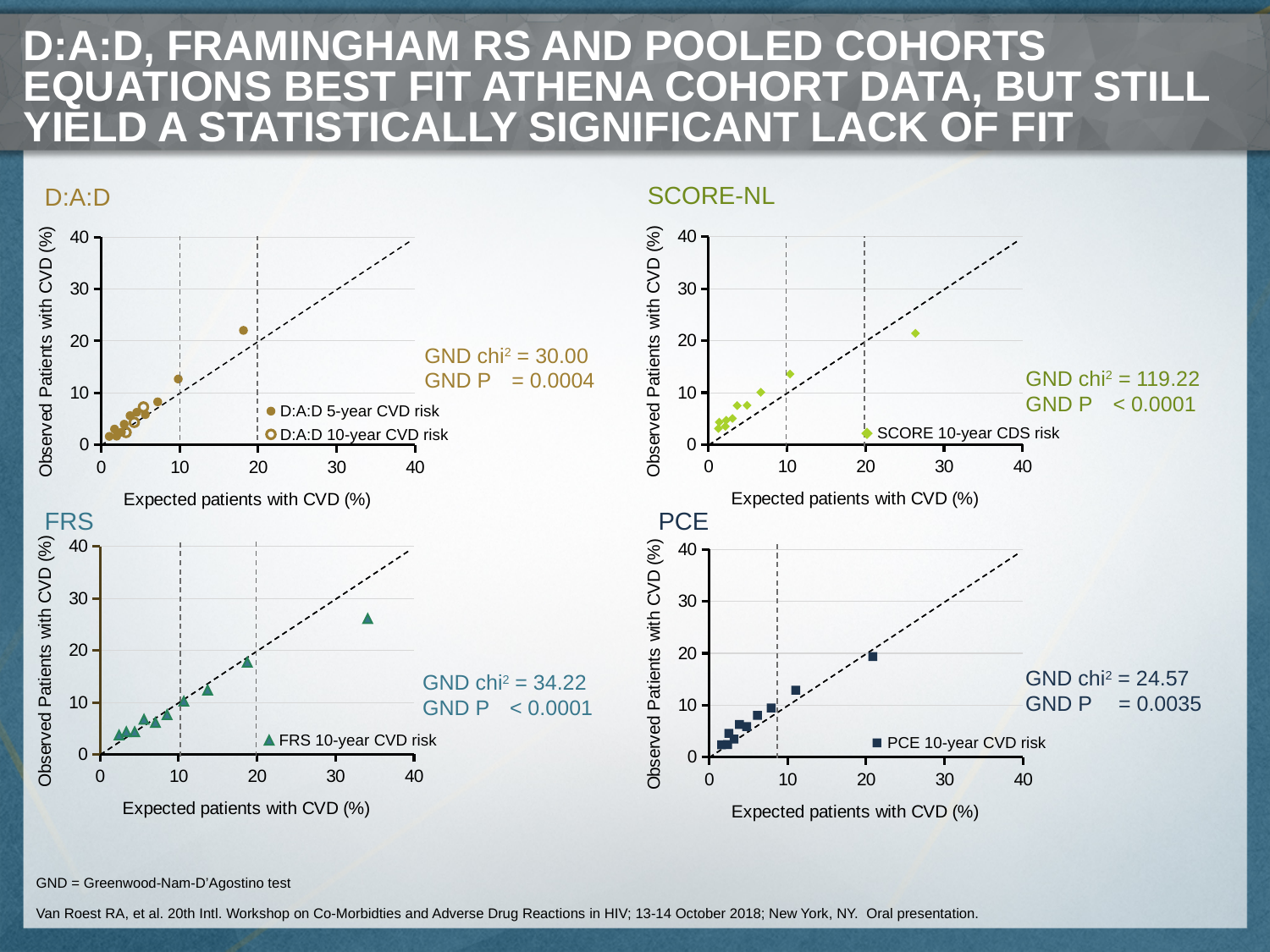
In the FRS chart, is the observed value for the point with the highest expected risk greater or less than 20? greater In the PCE chart, is the expected value for the rightmost point greater or less than 30? less In the SCORE-NL chart, is the expected value for the rightmost point greater or less than 20? greater What kind of chart is the D:A:D chart? scatter chart How many series does the legend of the D:A:D chart list? 2 What is the label of the x axis on the SCORE-NL chart? Expected patients with CVD (%) What is the legend entry on the PCE chart? PCE 10-year CVD risk In the PCE chart, do the observed values rise or fall as the expected values increase? rise How many series does the legend of the FRS chart list? 1